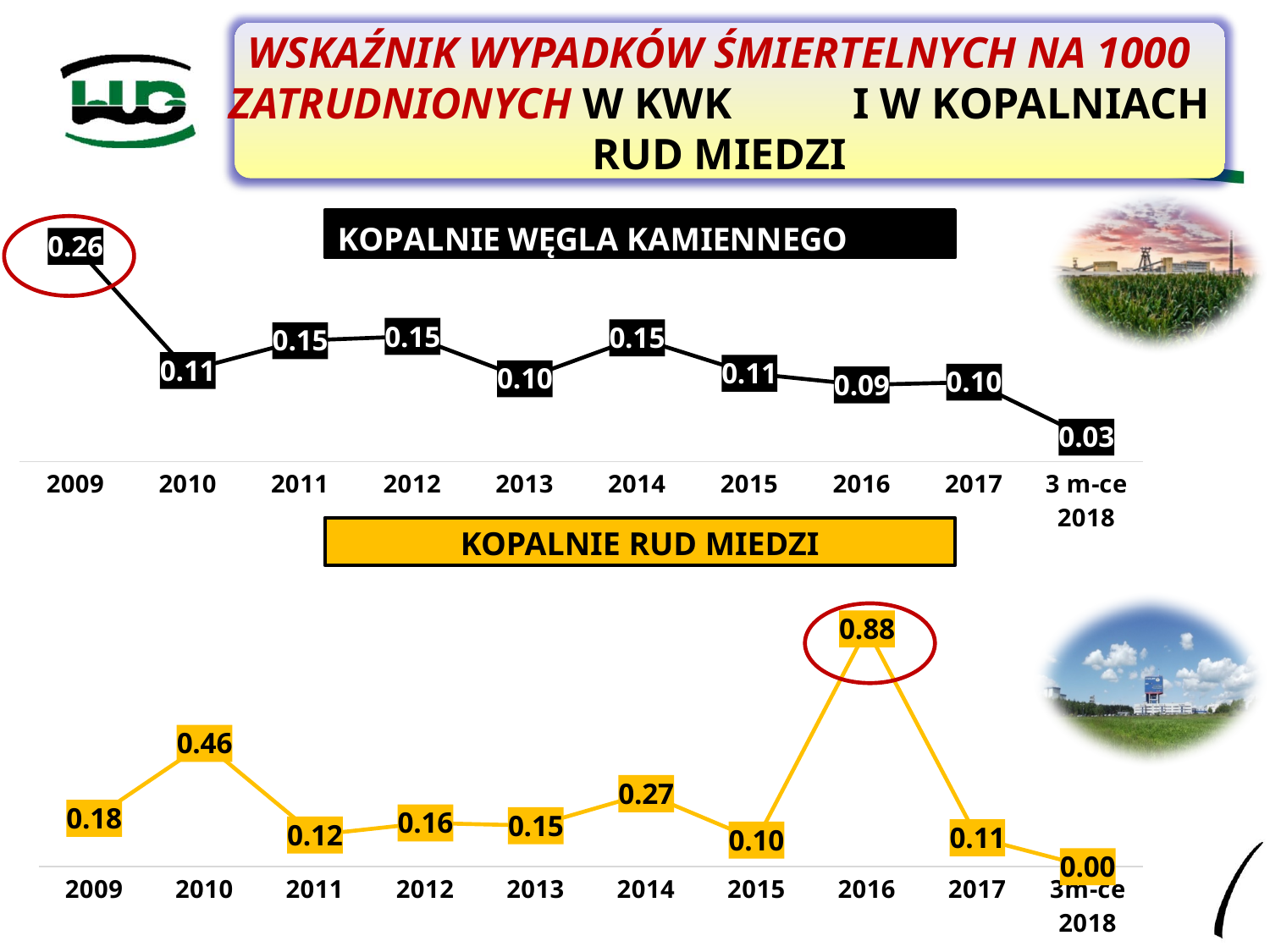
How many data points are plotted in the KOPALNIE RUD MIEDZI chart? 10 In the KOPALNIE RUD MIEDZI chart, what is the difference between the values for 2016 and 2010? 0.42 In the KOPALNIE WĘGLA KAMIENNEGO chart, which is larger, the value for 2011 or the value for 2016? 2011 In the KOPALNIE WĘGLA KAMIENNEGO chart, does the value rise or fall from 2017 to 3 m-ce 2018? Fall In the KOPALNIE WĘGLA KAMIENNEGO chart, what is the difference between the values for 2009 and 2010? 0.15 In the KOPALNIE WĘGLA KAMIENNEGO chart, what is the value for 2009? 0.26 What colour is the line in the KOPALNIE RUD MIEDZI chart? Yellow In the KOPALNIE WĘGLA KAMIENNEGO chart, which year has the lowest value? 3 m-ce 2018 In the KOPALNIE RUD MIEDZI chart, which is larger, the value for 2014 or the value for 2015? 2014 In the KOPALNIE RUD MIEDZI chart, what is the value for 2016? 0.88 What kind of chart is the KOPALNIE WĘGLA KAMIENNEGO chart? Line chart In the KOPALNIE RUD MIEDZI chart, which year has the highest value? 2016